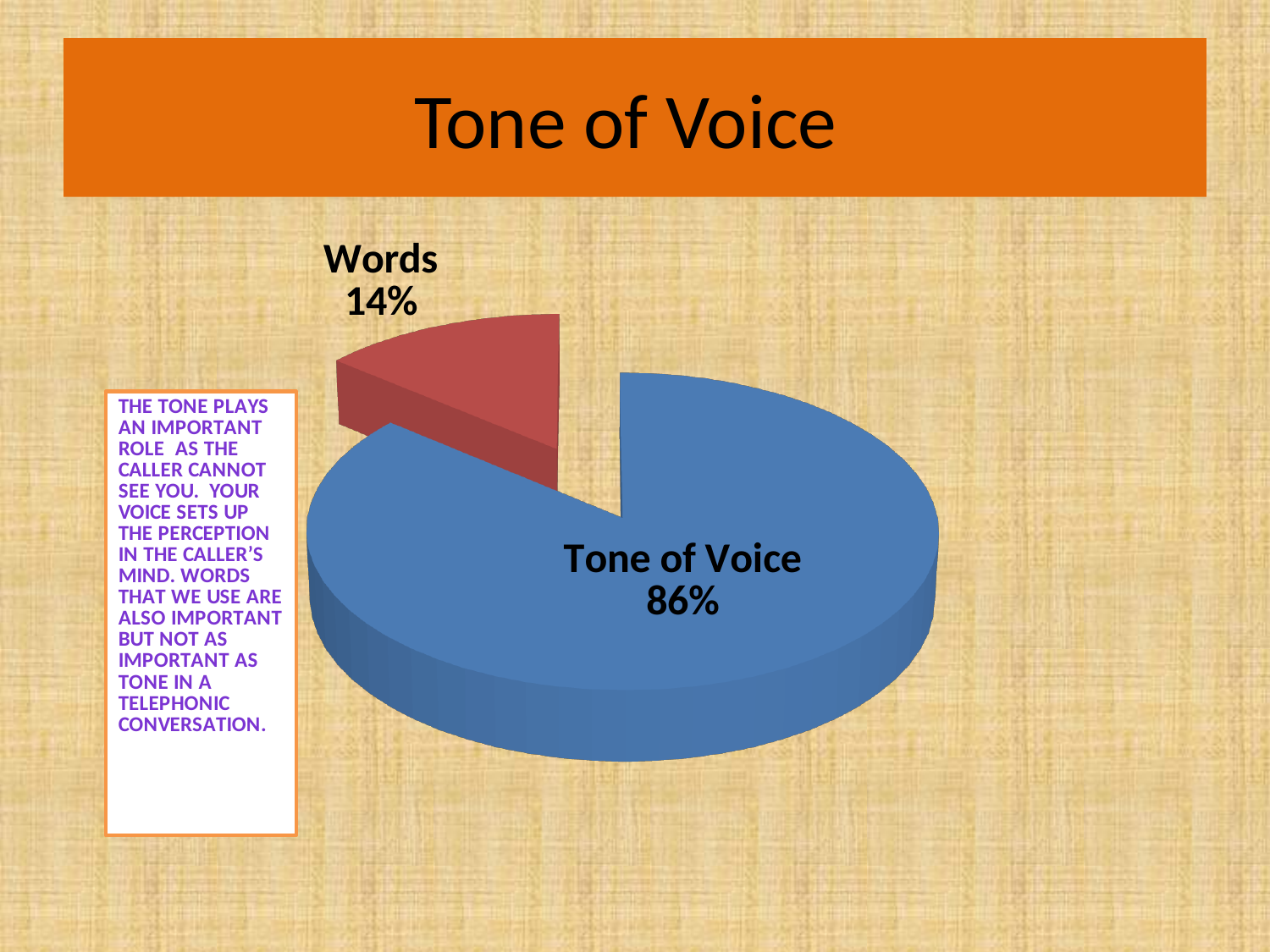
What kind of chart is shown on the slide? pie chart Which slice of the pie is the smallest? Words What is the title of the slide containing the pie chart? Tone of Voice Which is larger, the Words slice or the Tone of Voice slice? Tone of Voice Is the value for Words greater or less than 50%? less What share of the pie does Tone of Voice account for? 86% What colour is the Words slice? red How many slices does the pie chart have? 2 What is the difference in percentage points between the Tone of Voice slice and the Words slice? 72 Which slice of the pie is the largest? Tone of Voice What share of the pie does Words account for? 14%